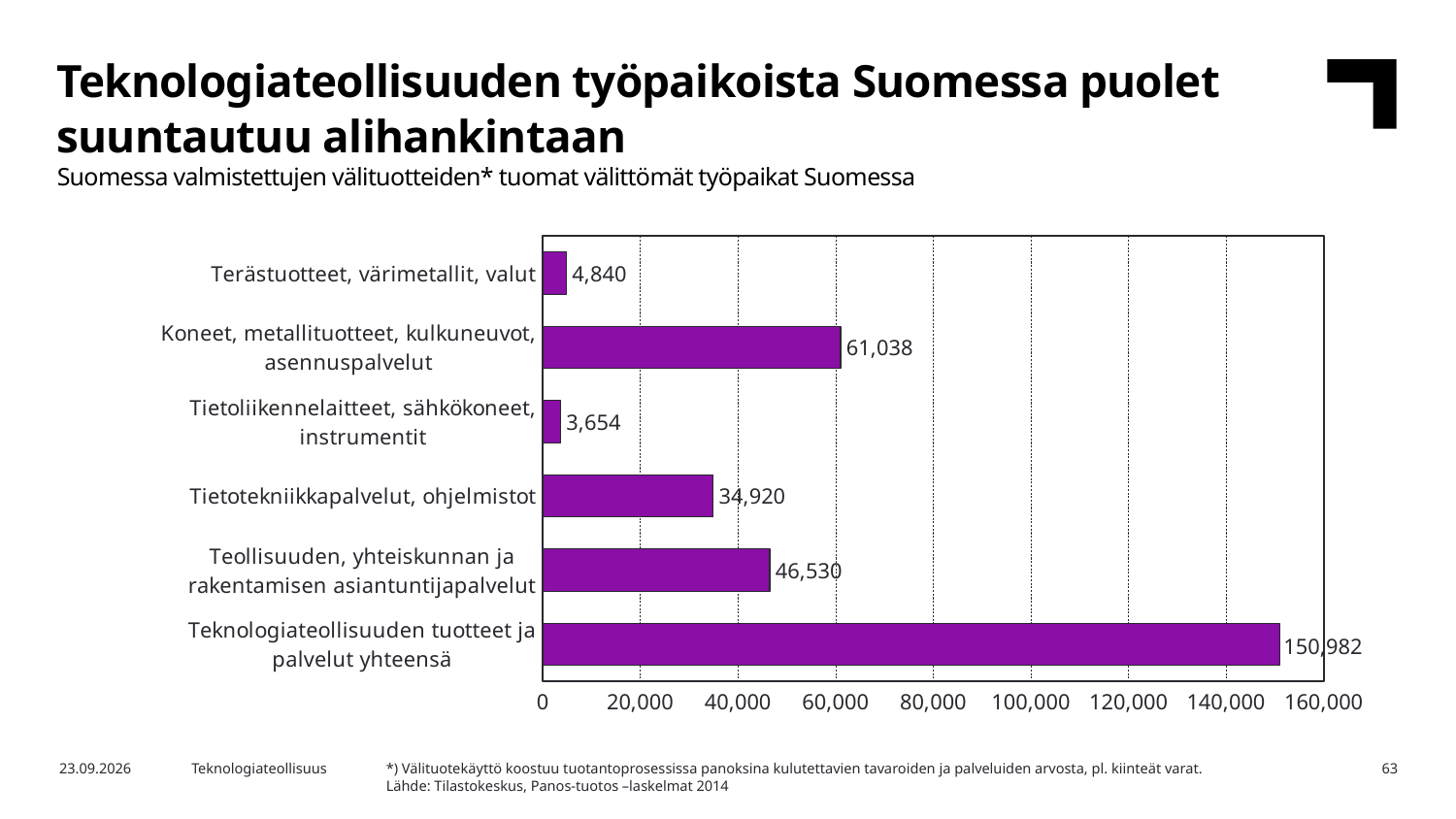
Is the value for Koneet, metallituotteet, kulkuneuvot, asennuspalvelut greater or less than 60,000? greater What kind of chart is shown on the slide? bar chart Which is larger: Tietotekniikkapalvelut, ohjelmistot or Teollisuuden, yhteiskunnan ja rakentamisen asiantuntijapalvelut? Teollisuuden, yhteiskunnan ja rakentamisen asiantuntijapalvelut What is the value for Teknologiateollisuuden tuotteet ja palvelut yhteensä? 150,982 What is the value for Terästuotteet, värimetallit, valut? 4,840 Which category has the highest value? Teknologiateollisuuden tuotteet ja palvelut yhteensä How many categories are shown in the chart? 6 What is the value for Tietotekniikkapalvelut, ohjelmistot? 34,920 What is the difference between Koneet, metallituotteet, kulkuneuvot, asennuspalvelut and Teollisuuden, yhteiskunnan ja rakentamisen asiantuntijapalvelut? 14,508 What is the difference between Terästuotteet, värimetallit, valut and Tietoliikennelaitteet, sähkökoneet, instrumentit? 1,186 Which category has the lowest value? Tietoliikennelaitteet, sähkökoneet, instrumentit What is the value for Koneet, metallituotteet, kulkuneuvot, asennuspalvelut? 61,038